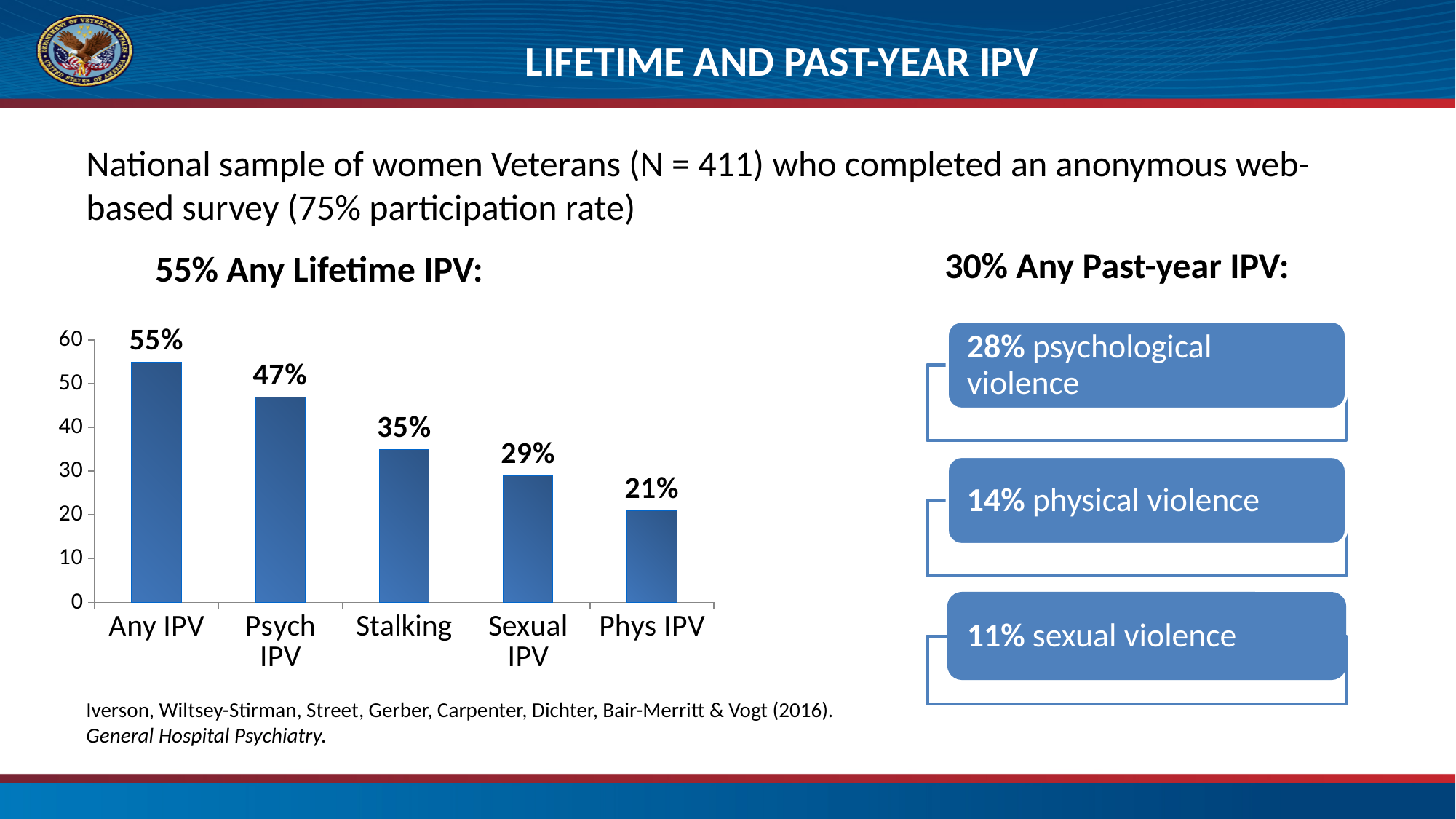
Is the value for Phys IPV in the bar chart greater or less than 30? less How many categories are shown in the bar chart? 5 What is the value for Psych IPV in the bar chart? 47% What kind of chart is shown on the slide? bar chart Which is larger in the bar chart, Stalking or Sexual IPV? Stalking What is the difference between the values for Any IPV and Phys IPV in the bar chart? 34% Which category has the lowest value in the bar chart? Phys IPV Which category has the highest value in the bar chart? Any IPV What is the value for Stalking in the bar chart? 35% Do the values in the bar chart rise or fall from left to right? fall What is the difference between the values for Psych IPV and Stalking in the bar chart? 12% What is the value for Sexual IPV in the bar chart? 29%